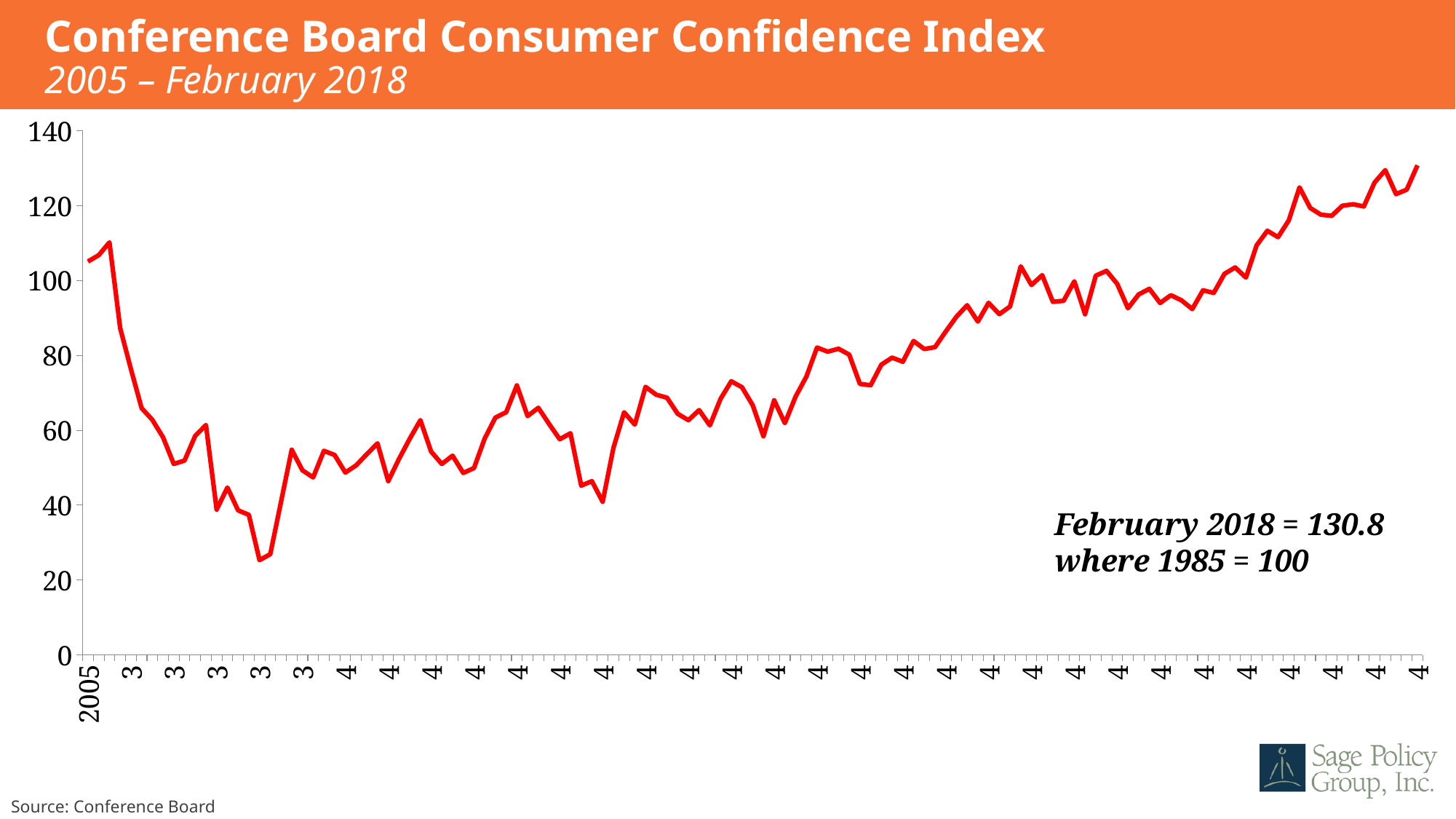
What is the highest tick value shown on the vertical axis? 140 How many data series are plotted on the chart? 1 What is the Conference Board Consumer Confidence Index value for February 2018, as stated on the slide? 130.8 Is the value at the start of the series in 2005 greater or less than 100? greater Is the value at the end of the series (February 2018) higher or lower than the value at the start (2005)? higher Over the second half of the chart, from roughly 2010 onward, does the index generally rise or fall? rise According to the annotation on the chart, which year is the index base where the value equals 100? 1985 What is the highest value reached by the line on the chart? 130.8 Is the lowest value on the chart greater or less than 40? less Is the final value of the series greater or less than 120? greater What kind of chart is shown on the slide? line chart